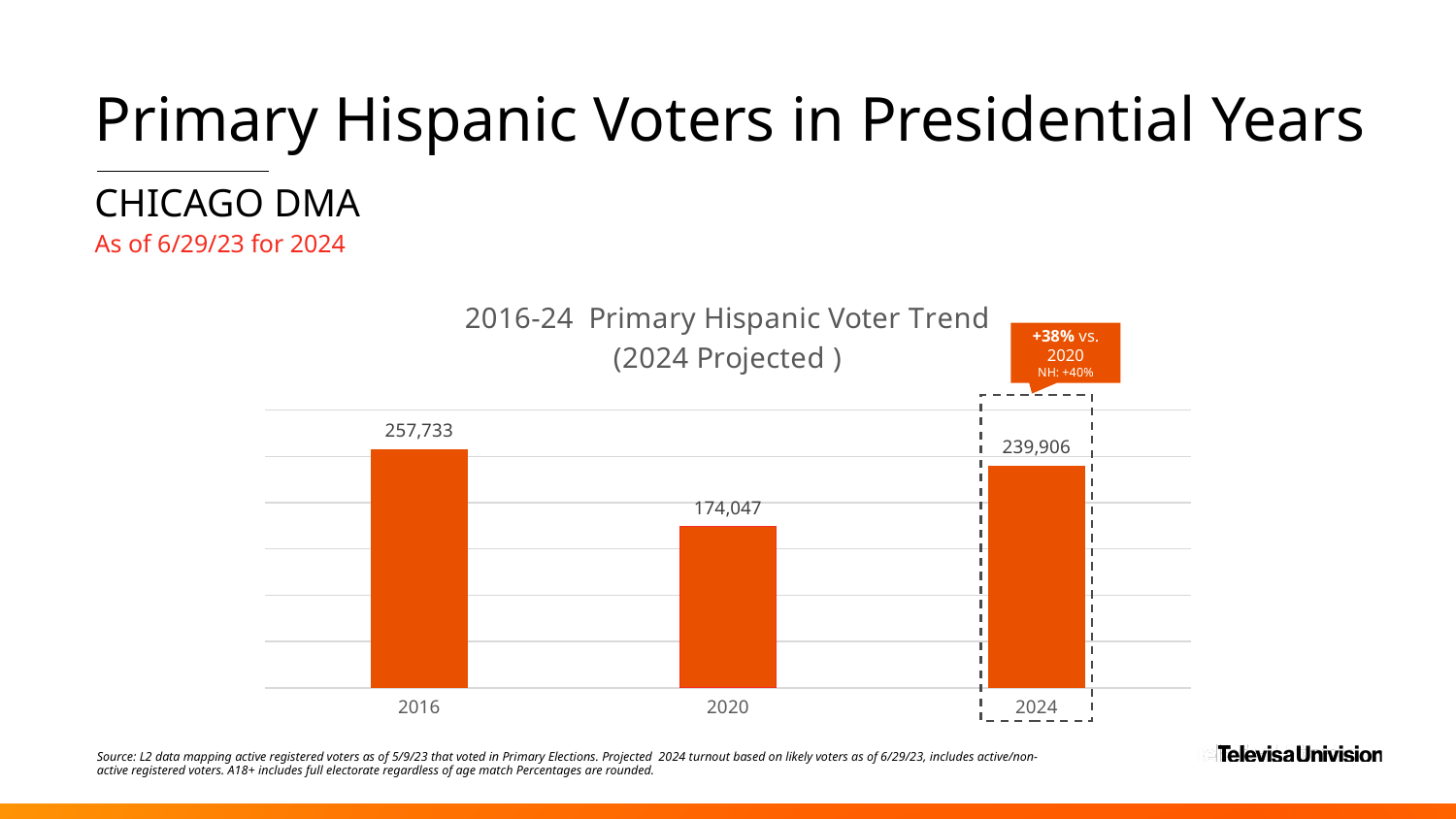
Which is larger, the value for 2016 or the value for 2024? 2016 What is the value for 2020? 174,047 What is the difference between the 2016 and 2020 values? 83,686 What is the difference between the 2024 and 2020 values? 65,859 What is the value for 2016? 257,733 What percentage change vs. 2020 is shown in the callout above the 2024 bar? +38% What is the title of the chart? 2016-24 Primary Hispanic Voter Trend (2024 Projected ) What is the projected value for 2024? 239,906 Which year has the lowest value? 2020 What kind of chart is this? Bar chart How many years are shown on the chart? 3 Which year has the highest value? 2016